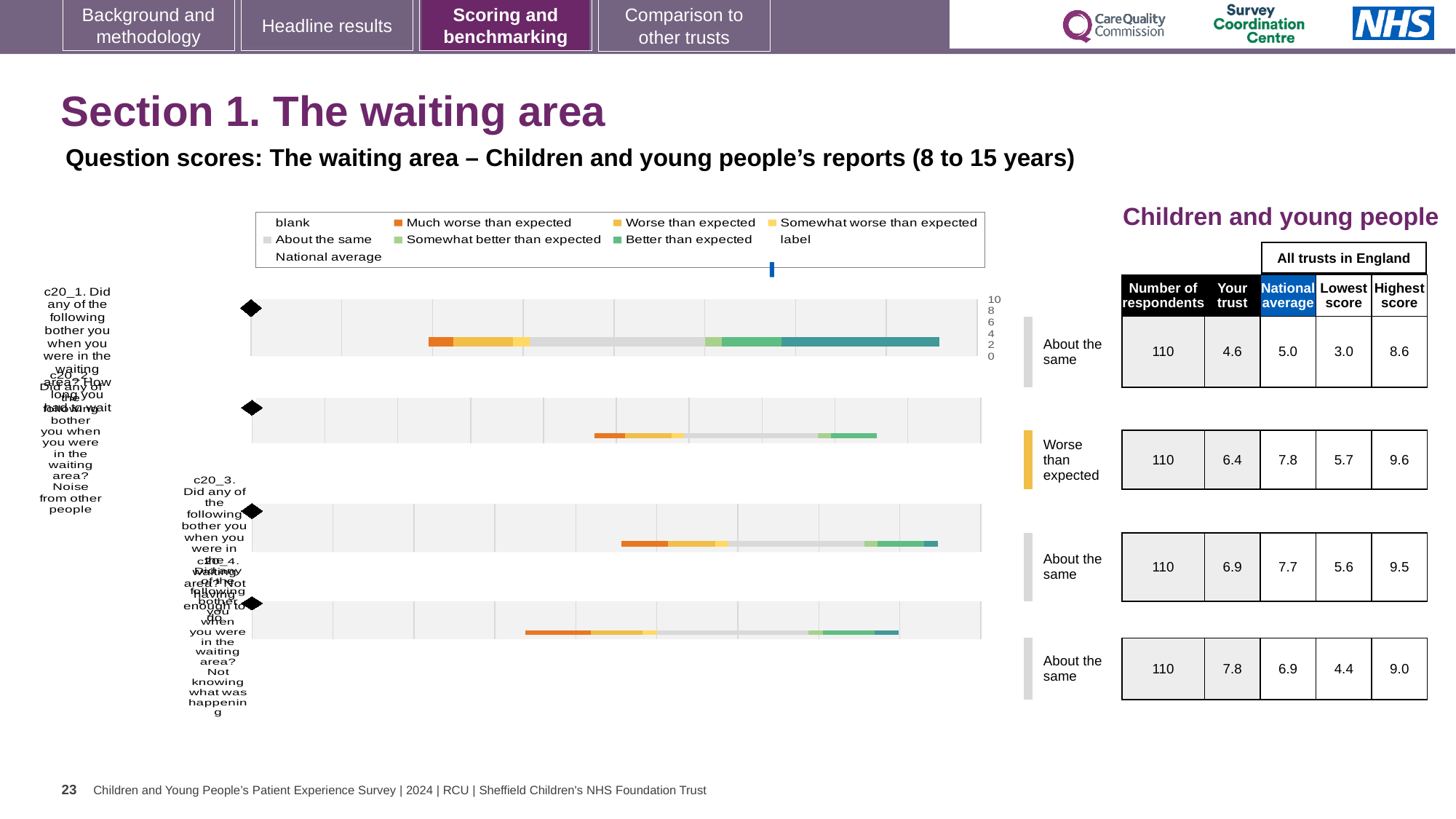
Which question bar has the lowest 'Your trust' score? the first (top) bar, 4.6 What is the highest score across all trusts in England for the fourth (bottom) question bar? 9.0 Which rating label is shown next to the second question bar? Worse than expected What kind of chart is used to show the question scores on this slide? bar chart Which question bar has the highest 'Your trust' score? the fourth (bottom) bar, 7.8 For the third question bar, which is larger: the 'Your trust' score or the national average? the national average How many question bars are plotted in the chart? 4 How many entries does the chart legend list? 9 What is the lowest score across all trusts in England for the third question bar? 5.6 What is the national average score for the second question bar? 7.8 For the second question bar, what is the difference between the national average and the 'Your trust' score? 1.4 What is the 'Your trust' score for the first (top) question bar? 4.6